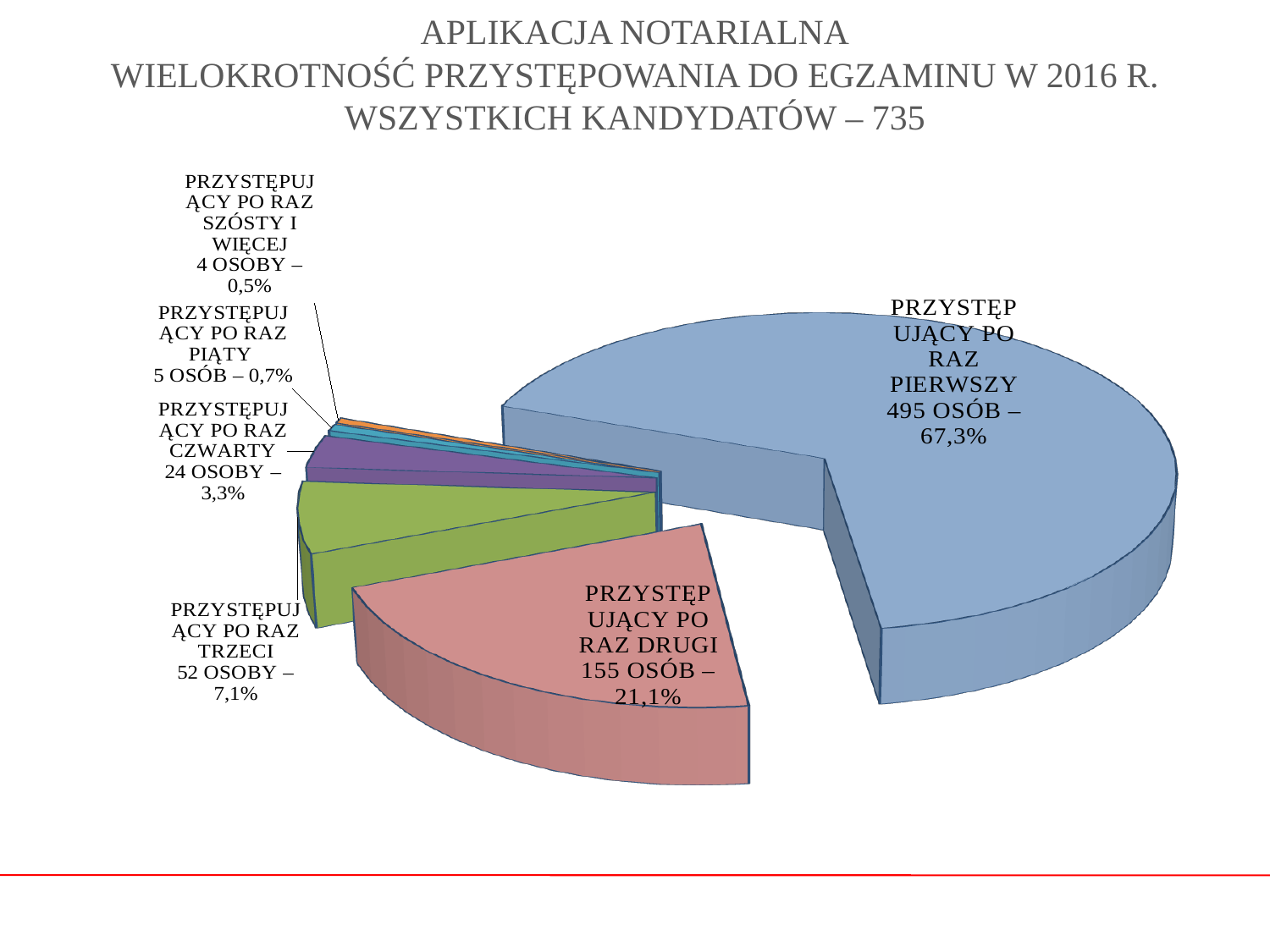
What total number of candidates is given in the chart title? 735 Which category has the smallest slice of the pie? PRZYSTĘPUJĄCY PO RAZ SZÓSTY I WIĘCEJ How many people are in the PRZYSTĘPUJĄCY PO RAZ TRZECI category? 52 OSOBY What percentage share is shown for PRZYSTĘPUJĄCY PO RAZ DRUGI? 21,1% What is the difference in number of people between PRZYSTĘPUJĄCY PO RAZ PIERWSZY and PRZYSTĘPUJĄCY PO RAZ DRUGI? 340 Which category has the largest slice of the pie? PRZYSTĘPUJĄCY PO RAZ PIERWSZY What kind of chart is shown on the slide? pie chart What percentage is shown for PRZYSTĘPUJĄCY PO RAZ CZWARTY? 3,3% How many people took the exam for the first time (PRZYSTĘPUJĄCY PO RAZ PIERWSZY)? 495 OSÓB What percentage is shown for PRZYSTĘPUJĄCY PO RAZ SZÓSTY I WIĘCEJ? 0,5% How many people took the exam for the fifth time (PRZYSTĘPUJĄCY PO RAZ PIĄTY)? 5 OSÓB How many slices does the pie chart have? 6